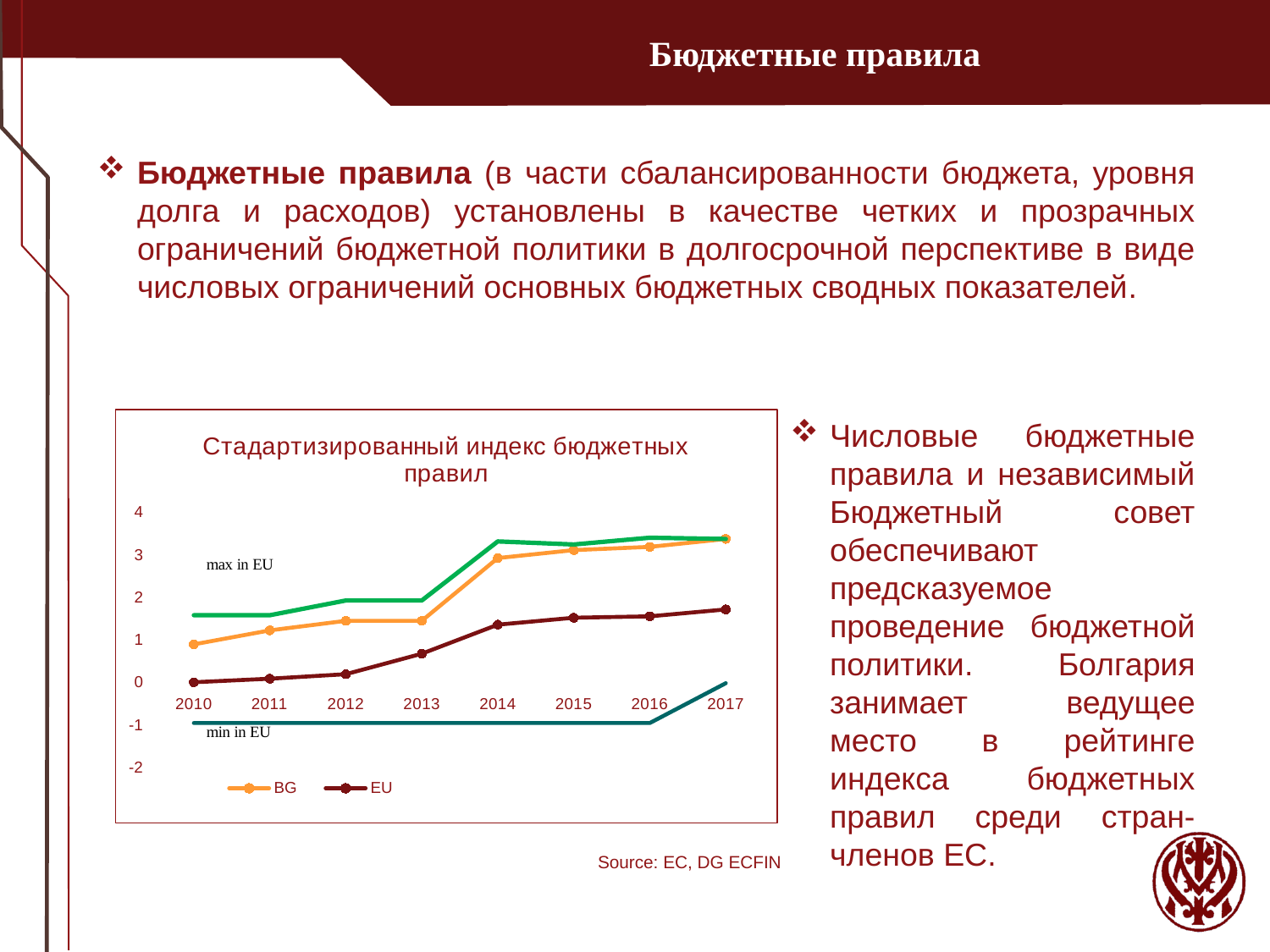
Is the value for BG in 2017 greater or less than 3? greater Does the BG series rise or fall from 2010 to 2017? rise Which series has the higher value in 2015, BG or EU? BG Is the value for EU in 2013 greater or less than 1? less How many years are shown on the x axis of the chart? 8 Is the value for EU in 2017 greater or less than 1? greater What is the title of the chart? Стадартизированный индекс бюджетных правил What kind of chart is shown on the slide? line chart How many series does the chart legend list? 2 What source is cited below the chart? EC, DG ECFIN